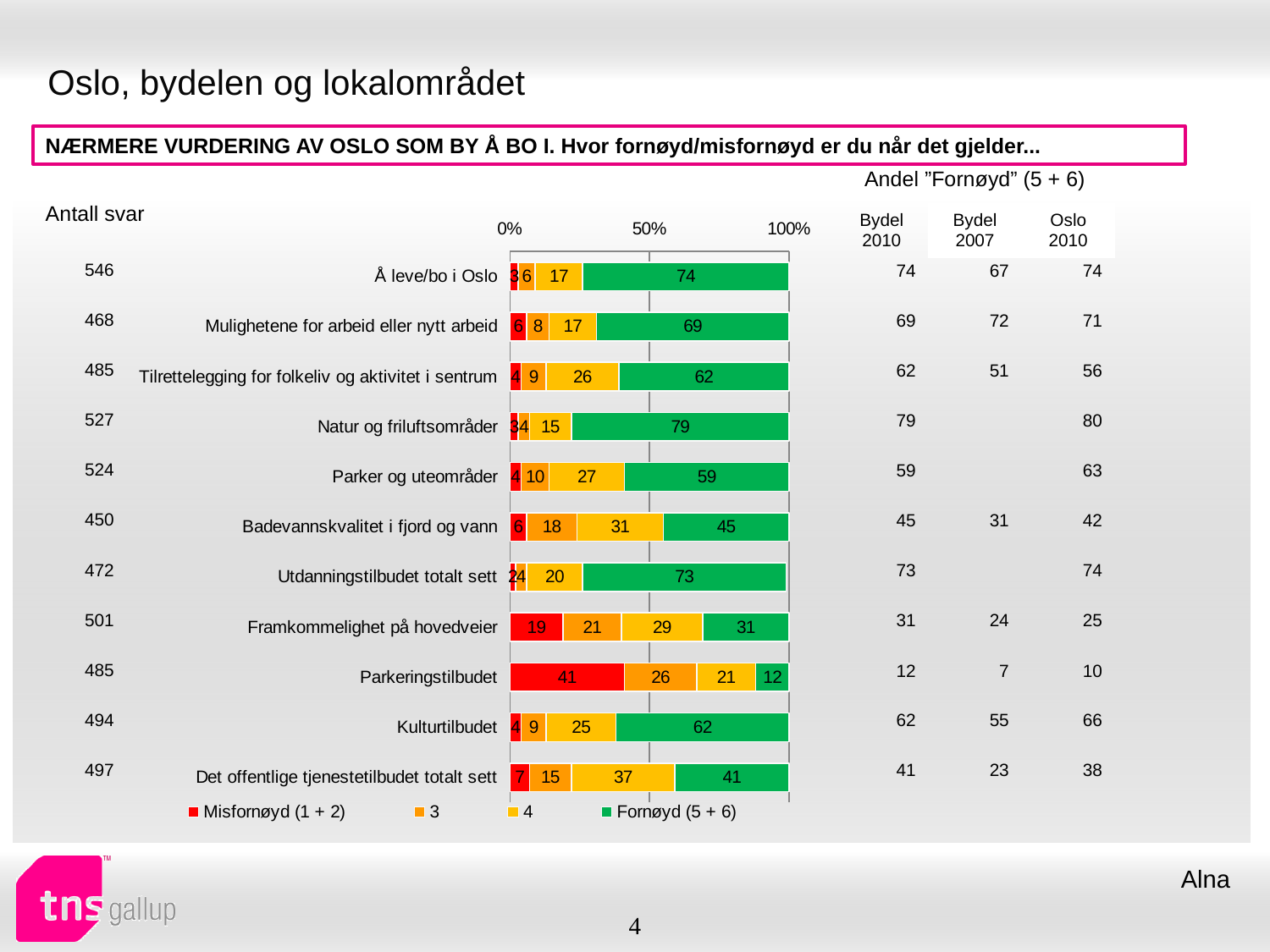
What is the Misfornøyd (1 + 2) value for Parkeringstilbudet? 41 What is the difference between the Fornøyd (5 + 6) values for Å leve/bo i Oslo and Badevannskvalitet i fjord og vann? 29 What is the value of the '4' series for Det offentlige tjenestetilbudet totalt sett? 37 Which category has the lowest Fornøyd (5 + 6) value? Parkeringstilbudet Which category has the highest Misfornøyd (1 + 2) value? Parkeringstilbudet What kind of chart is shown on the slide? Stacked bar chart Which has a larger Fornøyd (5 + 6) value, Kulturtilbudet or Parker og uteområder? Kulturtilbudet What colour represents Fornøyd (5 + 6) in the chart? Green How many categories are shown in the chart? 11 Which category has the highest Fornøyd (5 + 6) value? Natur og friluftsområder How many series does the legend list? 4 What is the Fornøyd (5 + 6) value for Natur og friluftsområder? 79